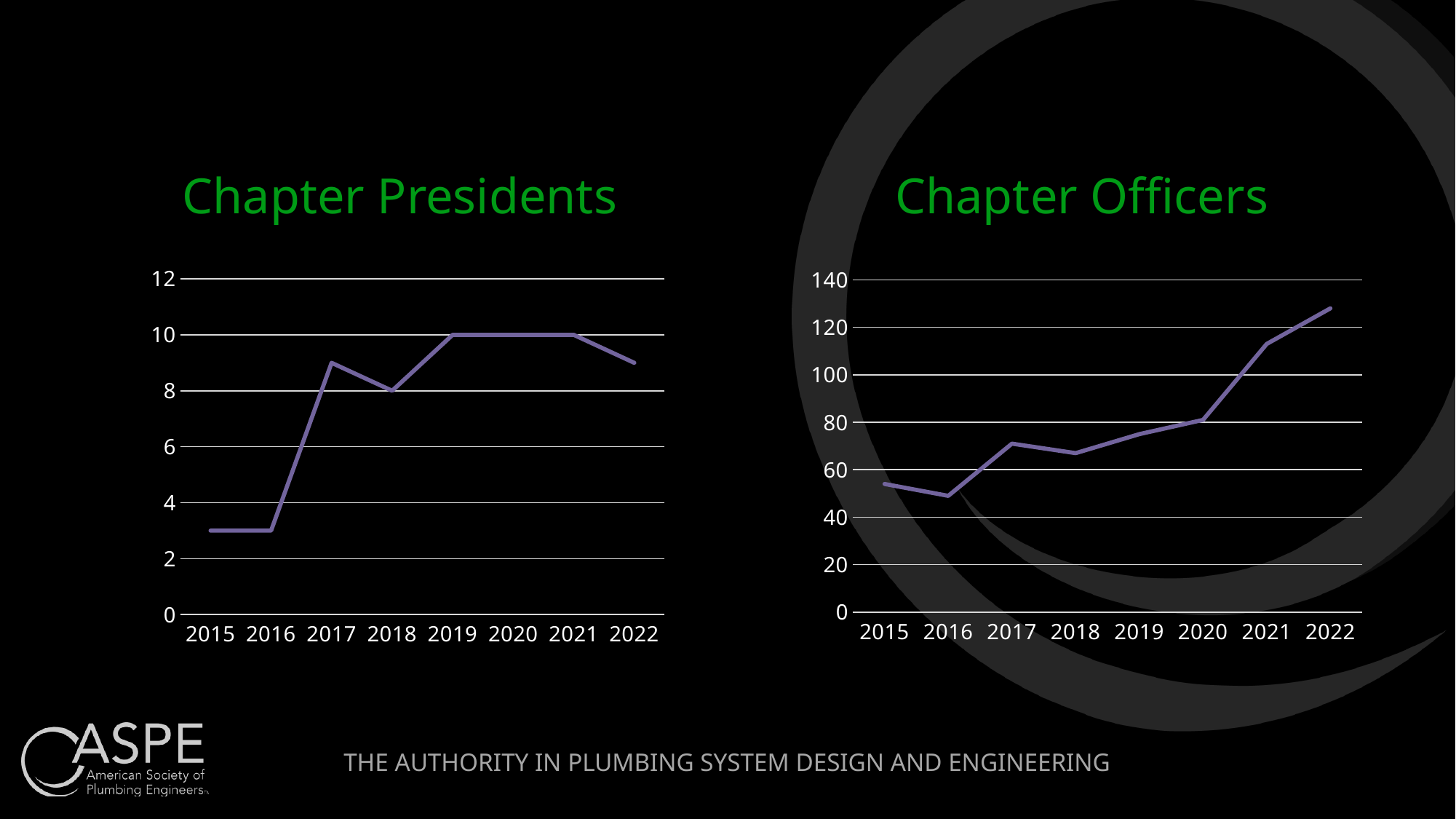
What is the highest value shown on the y axis of the Chapter Officers chart? 140 On the Chapter Presidents chart, what is the value for 2019? 10 On the Chapter Officers chart, which year has the lowest value? 2016 What kind of chart is the Chapter Presidents chart? line chart On the Chapter Officers chart, is the value for 2016 greater or less than 60? less On the Chapter Officers chart, which year has the highest value? 2022 How many years are plotted on the Chapter Officers chart? 8 On the Chapter Presidents chart, is the value for 2015 greater or less than 4? less On the Chapter Officers chart, is the value for 2022 greater or less than 120? greater On the Chapter Presidents chart, what is the value for 2018? 8 On the Chapter Officers chart, which year has the larger value, 2017 or 2021? 2021 On the Chapter Officers chart, do the values generally rise or fall from 2015 to 2022? rise